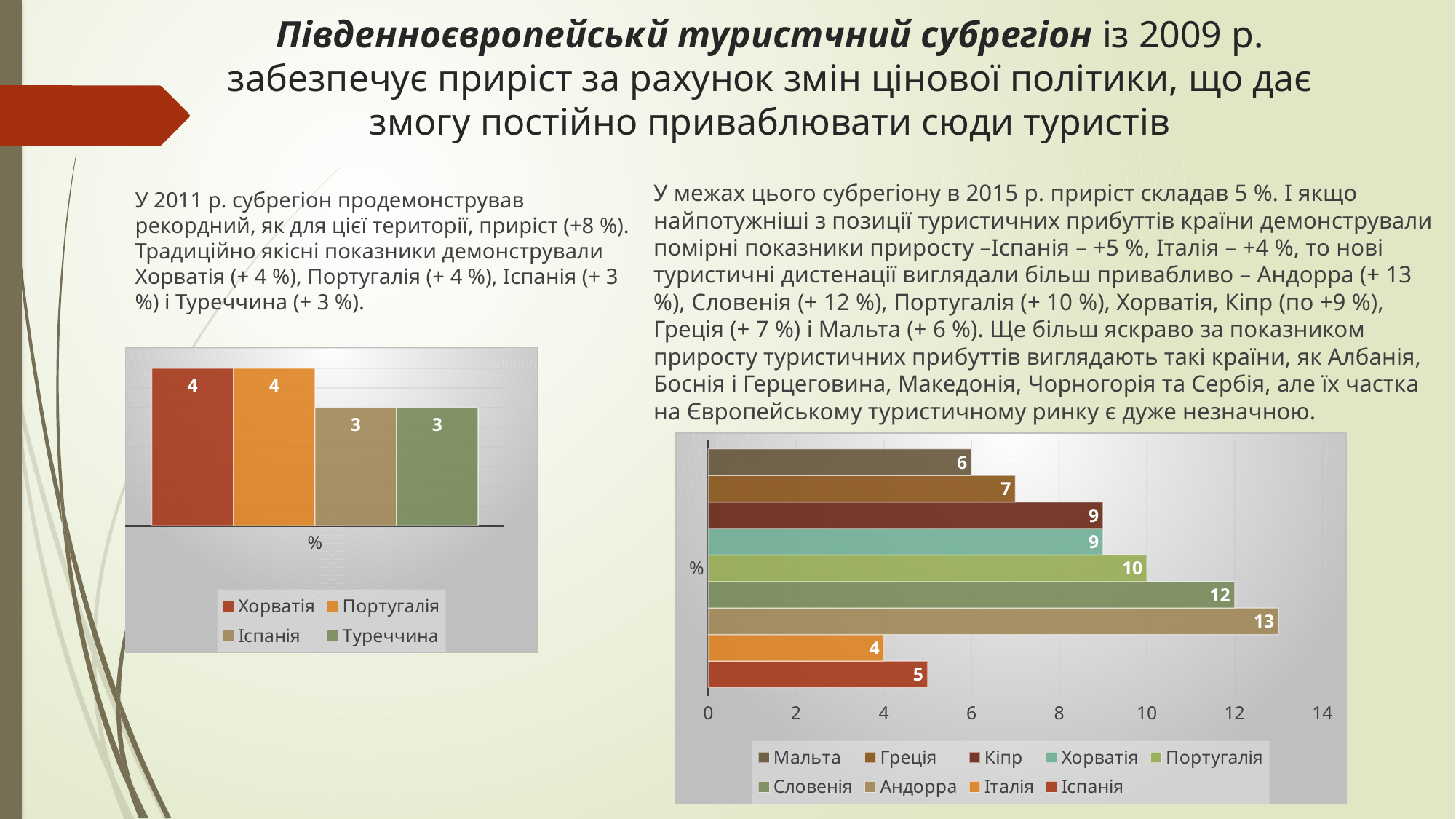
How many series does the legend of the chart on the right of the slide list? 9 How many series does the legend of the chart on the left of the slide list? 4 In the chart on the right of the slide, which is larger, the value for Португалія or the value for Греція? Португалія In the chart on the right of the slide, what is the difference between the values for Андорра and Іспанія? 8 In the chart on the right of the slide, which country has the highest value? Андорра In the chart on the left of the slide, what is the value for Хорватія? 4 In the chart on the right of the slide, what is the value for Словенія? 12 In the chart on the left of the slide, what is the value for Туреччина? 3 In the chart on the right of the slide, what is the value for Андорра? 13 In the chart on the left of the slide, what is the difference between the values for Португалія and Іспанія? 1 What kind of chart is the chart on the right of the slide? Bar chart In the chart on the right of the slide, which country has the lowest value? Італія